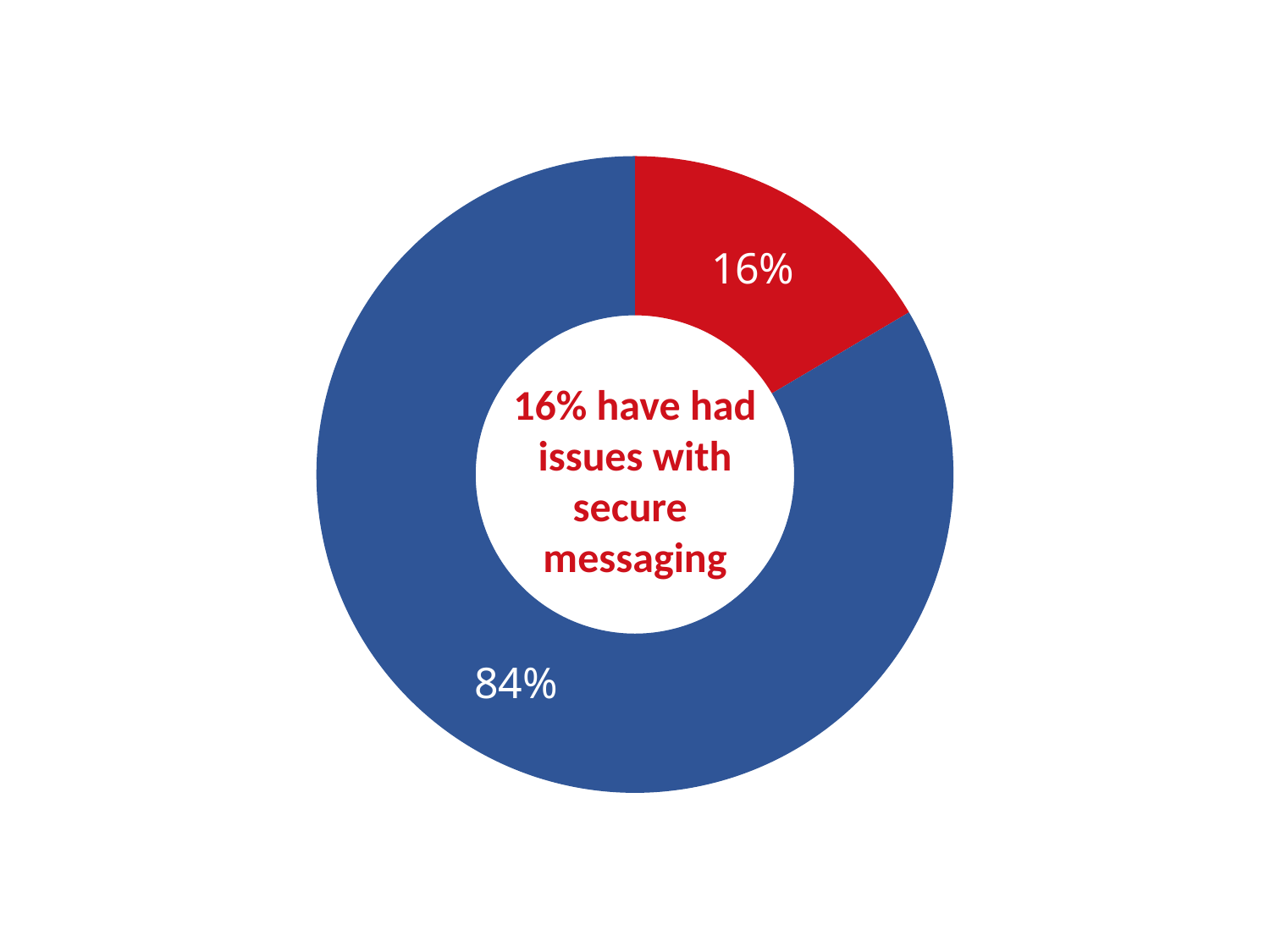
How many slices does the chart have? 2 What is the difference between the blue slice and the red slice? 68% What does the text in the centre of the chart say? 16% have had issues with secure messaging What kind of chart is shown on the slide? Doughnut (pie) chart Which slice is the largest? The blue slice (84%) Which is larger, the red slice or the blue slice? The blue slice What share of the chart does the red slice represent? 16% What percentage is shown on the blue slice? 84% What colour is the slice representing those who have had issues with secure messaging? Red What percentage is shown on the red slice? 16% What do the two slices add up to? 100% Which slice is the smallest? The red slice (16%)